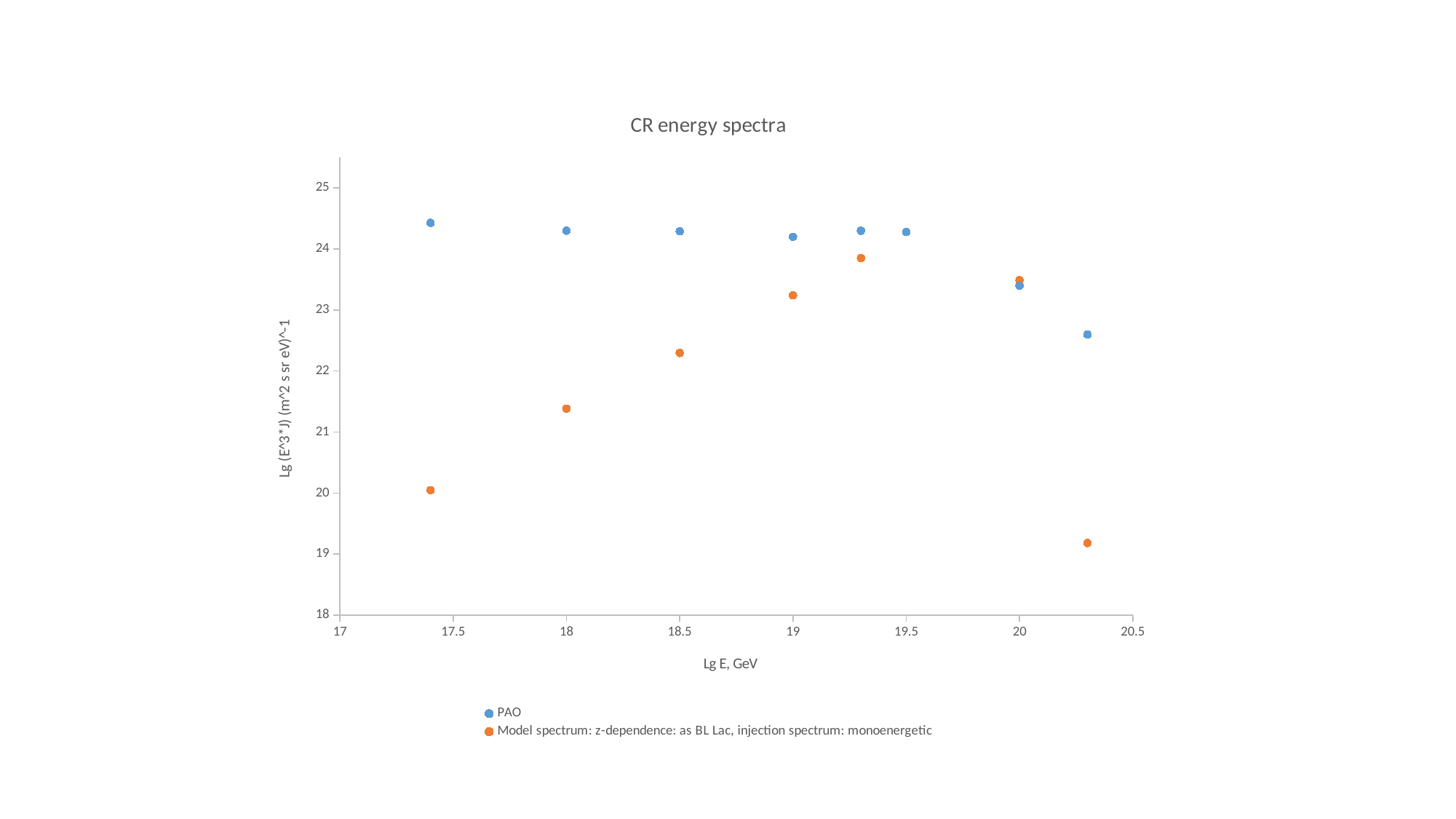
Is the Model spectrum value at Lg E = 19.3 greater or less than 24? less What is the title of the chart? CR energy spectra Is the PAO value at Lg E = 20.3 greater or less than 23? less How many data points are plotted for the PAO series? 8 How many series does the legend list? 2 What kind of chart is shown on the slide? Scatter chart Is the PAO value at Lg E = 17.4 greater or less than 24? greater At which Lg E value does the Model spectrum series reach its lowest point? 20.3 At Lg E = 18, which series has the larger value, PAO or the Model spectrum? PAO